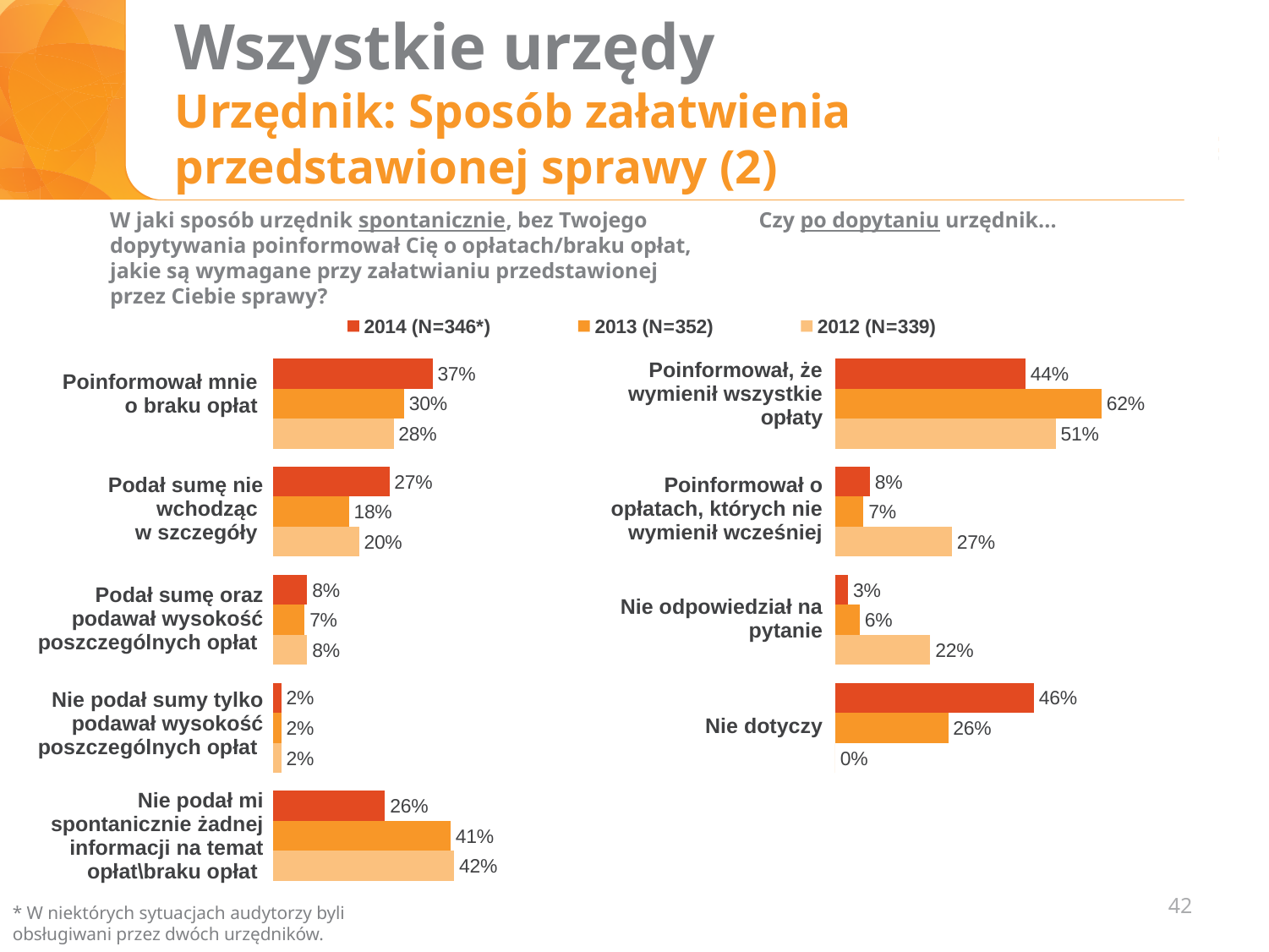
In the right chart, what is the 2012 value for "Nie dotyczy"? 0% In the right chart, what is the 2013 value for "Poinformował, że wymienił wszystkie opłaty"? 62% In the left chart, which category has the lowest 2013 value? Nie podał sumy tylko podawał wysokość poszczególnych opłat In the left chart, what is the 2014 value for "Poinformował mnie o braku opłat"? 37% In the right chart, what is the difference between the 2014 and 2013 values for "Nie dotyczy"? 20 percentage points How many categories are shown in the left chart? 5 What type of chart is the right chart? Bar chart In the left chart, what is the 2012 value for "Nie podał mi spontanicznie żadnej informacji na temat opłat\braku opłat"? 42% How many series does the legend list? 3 In the left chart, which is larger for "Podał sumę nie wchodząc w szczegóły": the 2014 value or the 2012 value? 2014 In the right chart, what is the difference between the 2012 and 2013 values for "Poinformował o opłatach, których nie wymienił wcześniej"? 20 percentage points In the right chart, which category has the highest 2014 value? Nie dotyczy